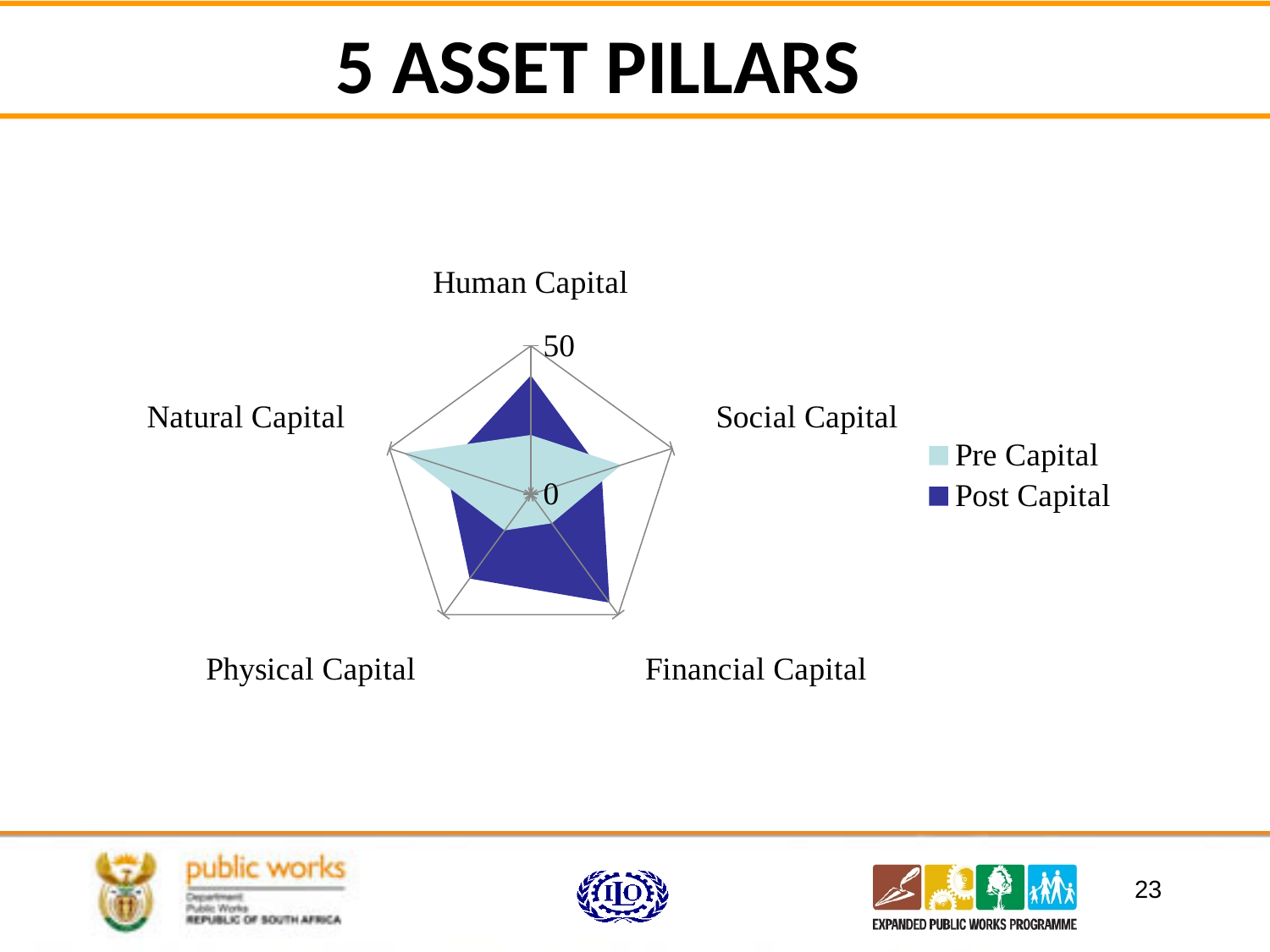
What are the two series named in the legend? Pre Capital and Post Capital Which category has the highest value in the Pre Capital series? Natural Capital For Financial Capital, which series has the larger value, Pre Capital or Post Capital? Post Capital What kind of chart is shown on the slide? radar chart Is the Pre Capital value for Social Capital greater or less than 50? less Is the Pre Capital value for Physical Capital greater or less than 50? less For Physical Capital, which series has the larger value, Pre Capital or Post Capital? Post Capital What is the maximum value shown on the radar chart's axis? 50 For Human Capital, which series has the larger value, Pre Capital or Post Capital? Post Capital How many series does the legend list? 2 How many categories (axes) does the radar chart have? 5 What is the title of the slide containing the chart? 5 ASSET PILLARS